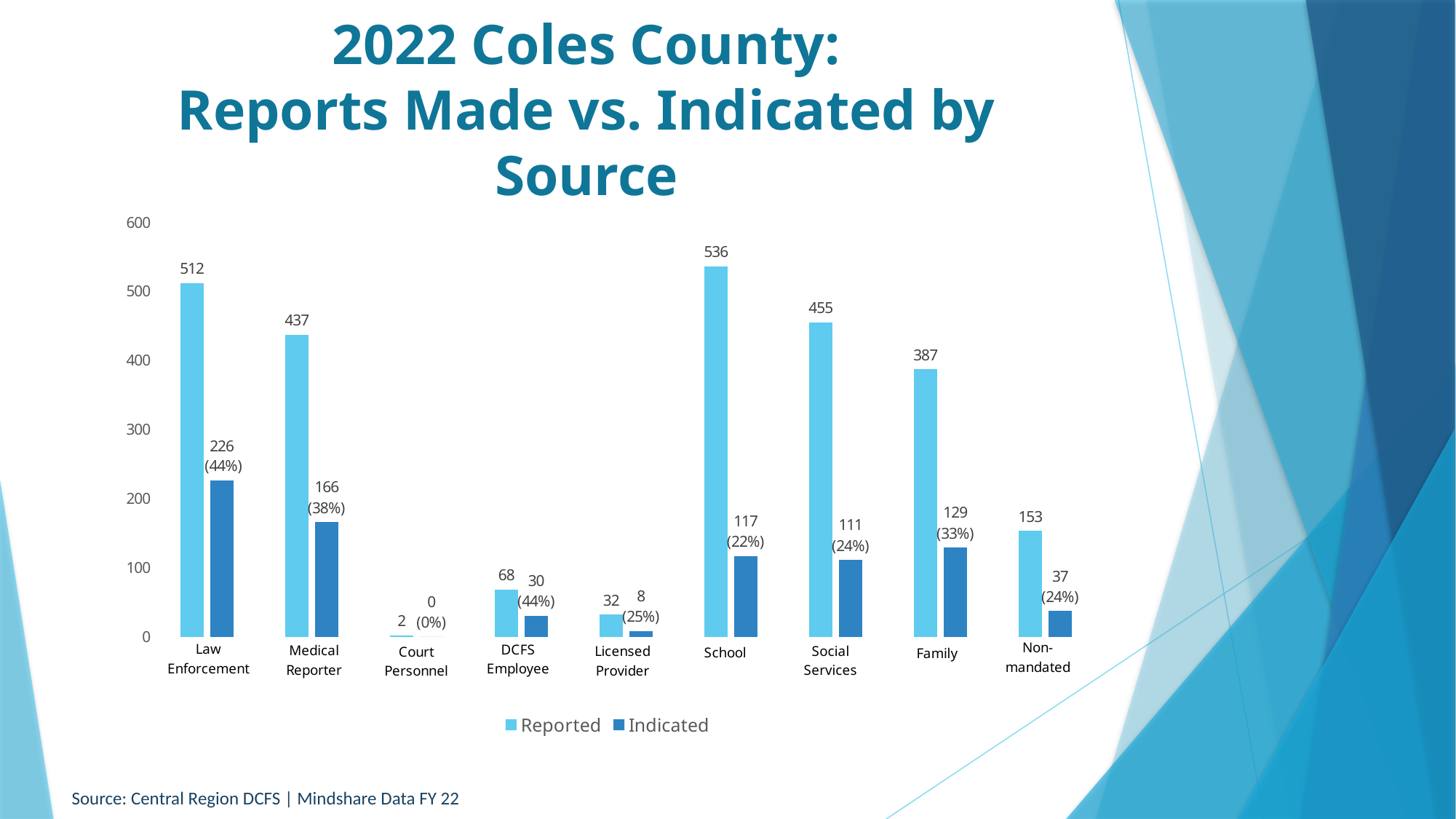
Which category has the highest Reported value? School What is the Indicated value for Law Enforcement? 226 What is the difference between the Reported and Indicated values for Medical Reporter? 271 Is the Indicated value for School greater or less than 100? greater How many series does the legend list? 2 Which is larger, the Reported value for Social Services or the Reported value for Family? Social Services What is the Reported value for School? 536 What is the Reported value for Non-mandated? 153 Which category has the lowest Indicated value? Court Personnel What kind of chart is shown on the slide? Bar chart How many source categories are shown on the x axis? 9 What percentage is shown next to the Indicated value for Family? 33%